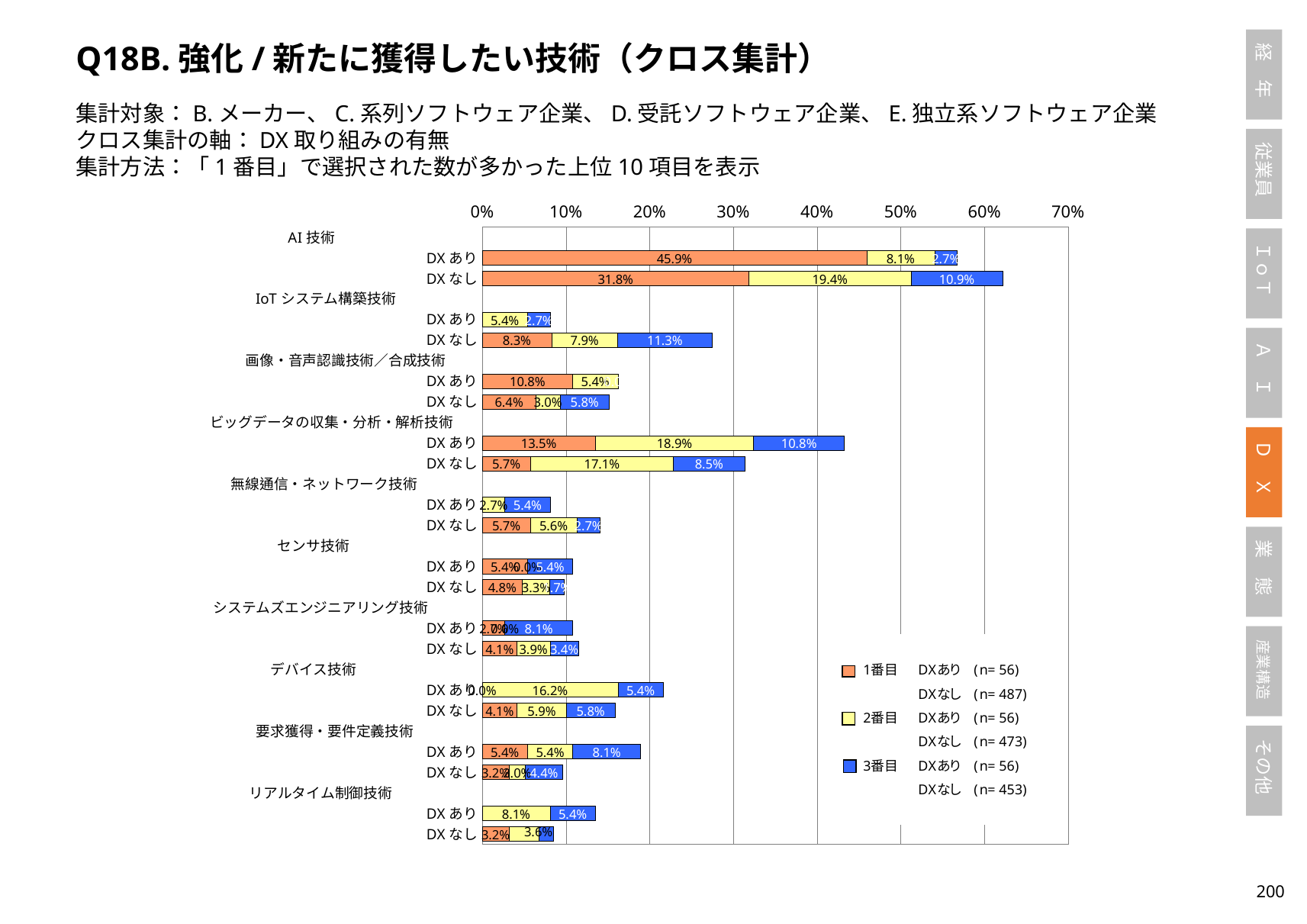
Which single segment in the chart has the highest value? AI 技術, DX あり, 1番目 (45.9%) What is the 2番目 value for AI 技術 among DX なし respondents? 19.4% What is the 1番目 value for AI 技術 among DX あり respondents? 45.9% What kind of chart is shown on the slide? Stacked horizontal bar chart For IoT システム構築技術 among DX なし respondents, which is larger: the 1番目 value or the 3番目 value? 3番目 (11.3%) What is the difference between the 1番目 value for AI 技術 for DX あり and for DX なし? 14.1 percentage points What is the 2番目 value for デバイス技術 among DX あり respondents? 16.2% What is the 3番目 value for IoT システム構築技術 among DX なし respondents? 11.3% How many series does the legend list? 3 What is the 2番目 value for ビッグデータの収集・分析・解析技術 among DX あり respondents? 18.9% What is the total stacked value for AI 技術 among DX なし respondents? 62.1% What is the total stacked value for ビッグデータの収集・分析・解析技術 among DX あり respondents? 43.2%